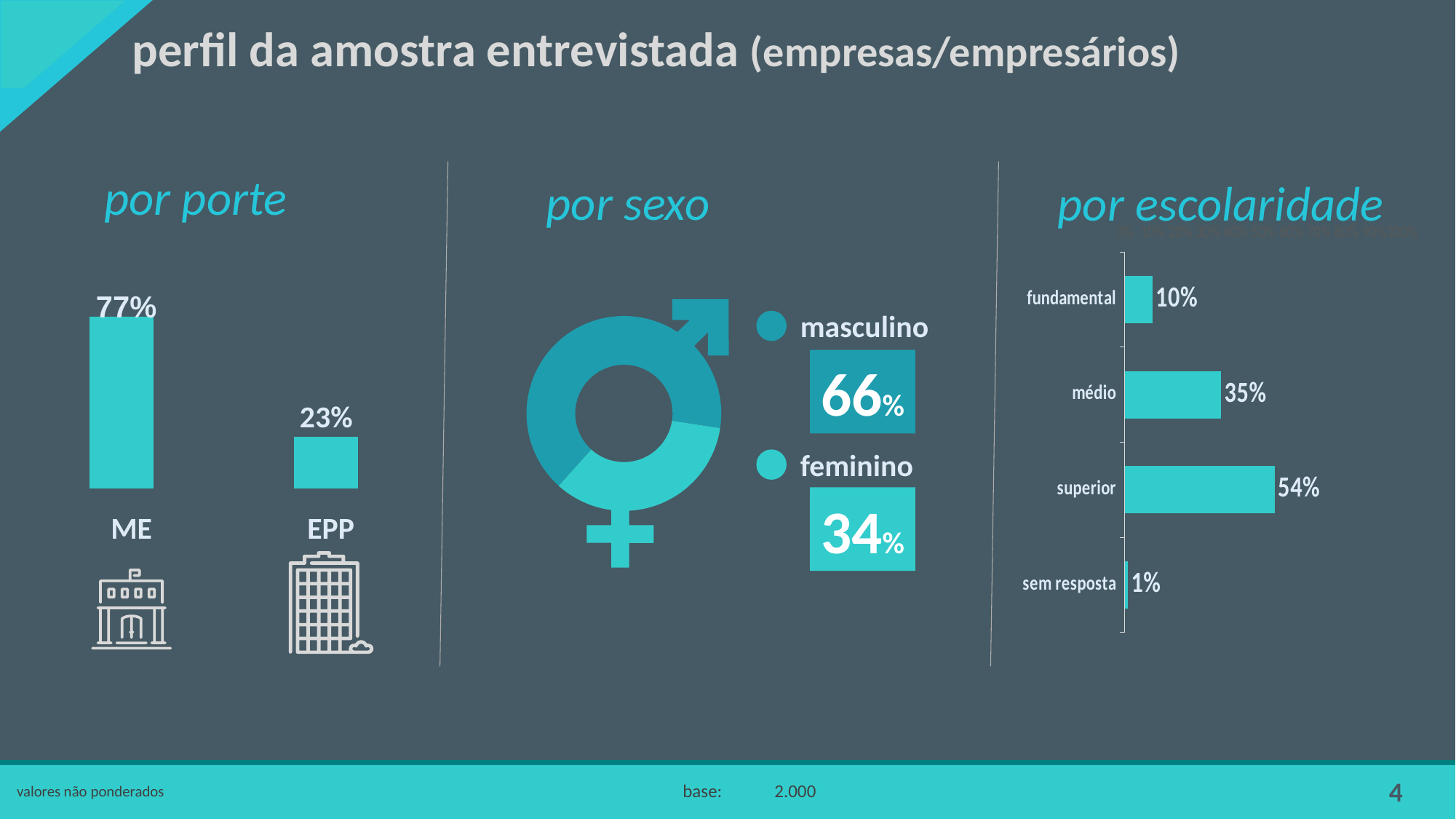
In the 'por porte' chart, how many categories are shown? 2 In the 'por escolaridade' chart, what is the value for médio? 35% What kind of chart is the 'por escolaridade' chart? bar chart In the 'por porte' chart, what is the value for EPP? 23% In the 'por sexo' chart, what is the share for masculino? 66% In the 'por porte' chart, what is the value for ME? 77% In the 'por sexo' chart, what is the share for feminino? 34% In the 'por escolaridade' chart, what is the difference between superior and fundamental? 44% In the 'por escolaridade' chart, which category has the highest value? superior In the 'por escolaridade' chart, which category has the lowest value? sem resposta In the 'por porte' chart, what is the difference between the ME and EPP values? 54% In the 'por sexo' chart, which is larger, masculino or feminino? masculino